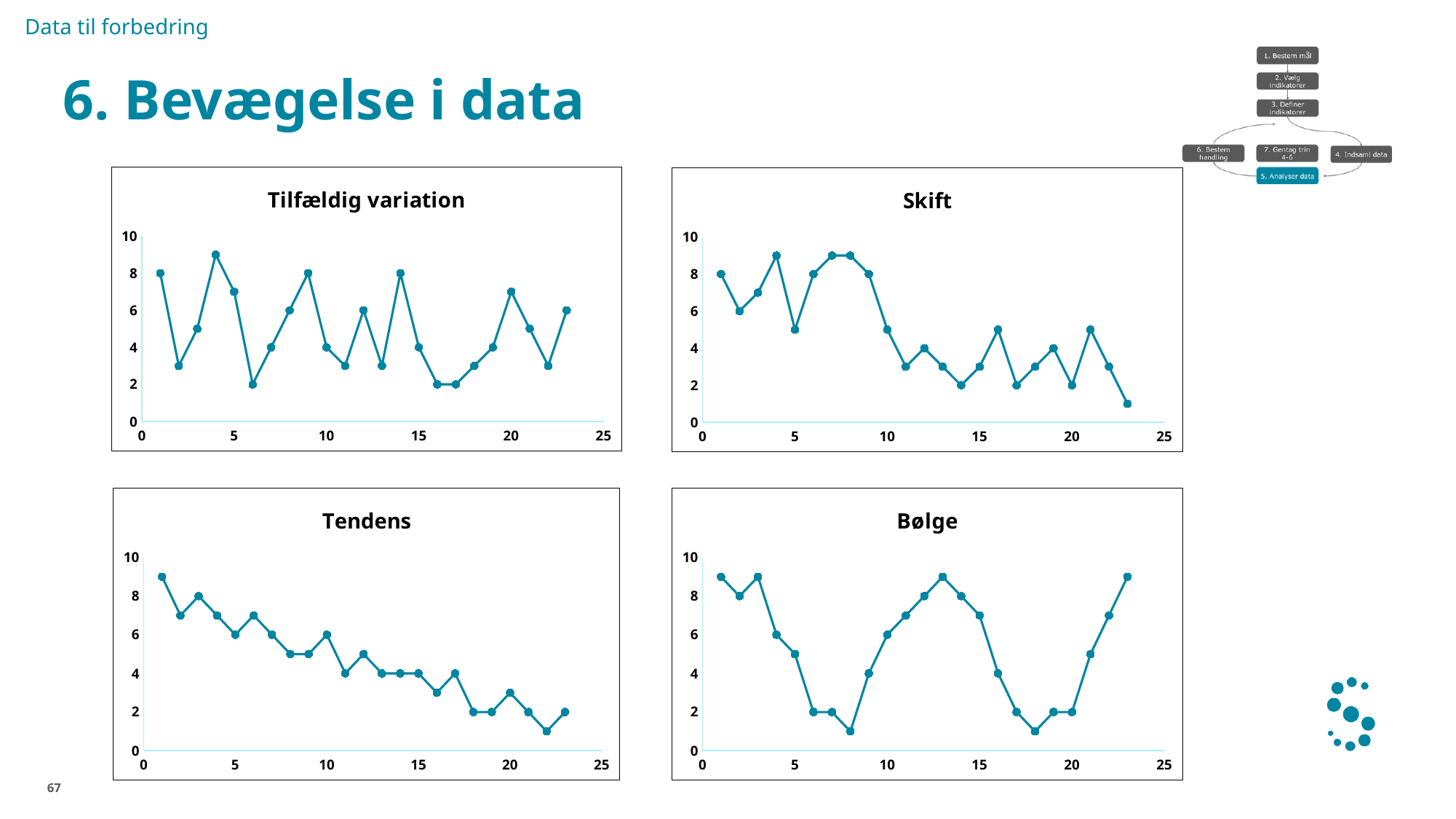
In the "Tendens" chart, is the value at x = 1 greater or less than 8? greater In the "Tilfældig variation" chart, what is the value at x = 1? 8 In the "Tilfældig variation" chart, what is the difference between the value at x = 1 and the value at x = 6? 6 In the "Tendens" chart, what is the value at x = 5? 6 In the "Tilfældig variation" chart, at which x value is the highest point? 4 What kind of chart is the "Tilfældig variation" chart? Line chart How many charts are shown on the slide? 4 In the "Skift" chart, is the value at x = 23 greater or less than 2? less In the "Bølge" chart, what is the value at x = 10? 6 In the "Skift" chart, what is the value at x = 1? 8 In the "Tendens" chart, do the values generally rise or fall along the x axis? Fall In the "Skift" chart, which is larger: the value at x = 1 or the value at x = 23? x = 1